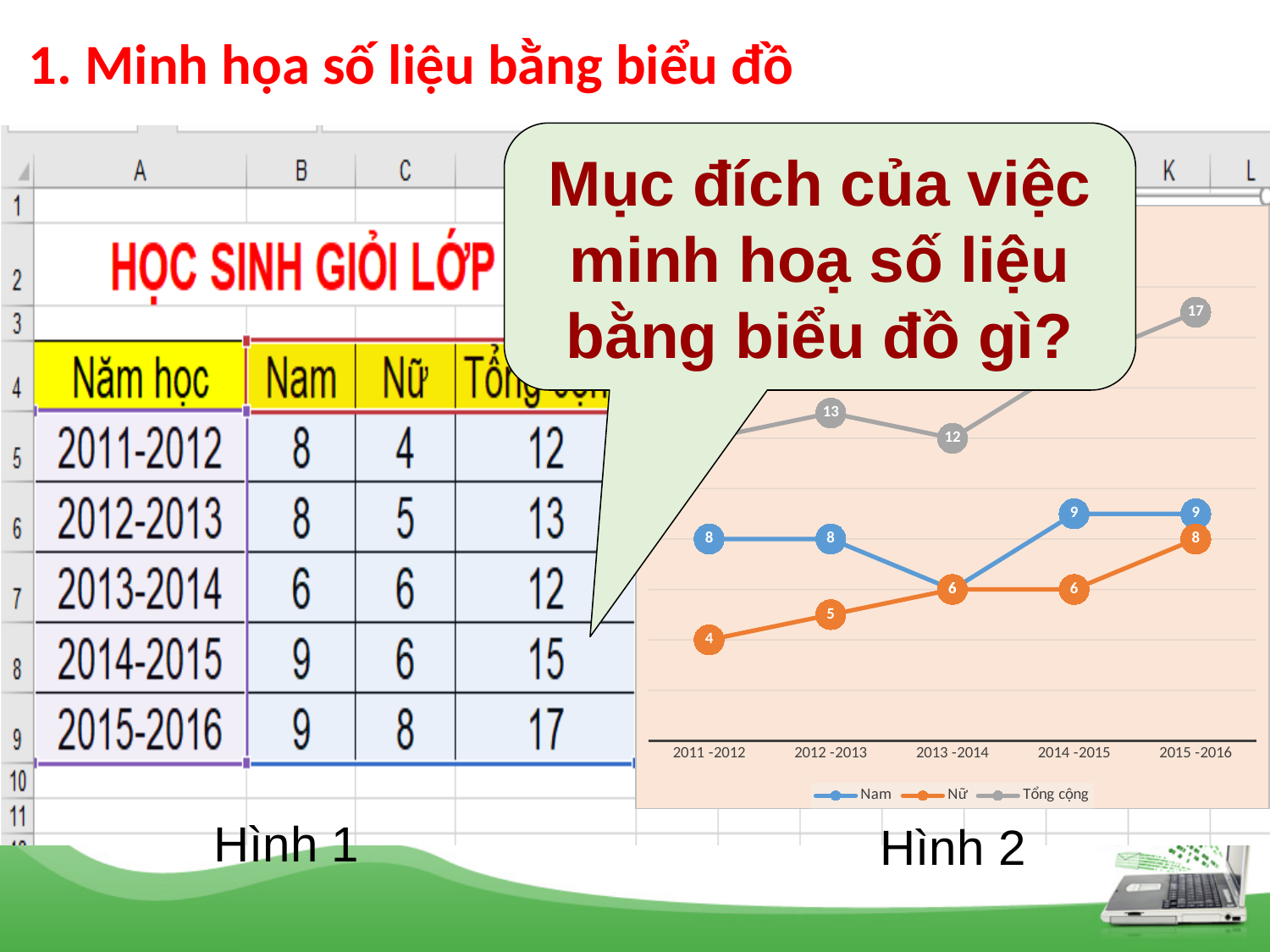
In the chart in Hình 2, which school year has the lowest value for Nữ? 2011-2012 In the chart in Hình 2, what is the value of Nam for 2013-2014? 6 What kind of chart is shown in Hình 2? line chart In the chart in Hình 2, what is the difference between Nam and Nữ for 2012-2013? 3 In the chart in Hình 2, does the Nữ series generally rise or fall from 2011-2012 to 2015-2016? rise In the chart in Hình 2, what is the value of Tổng cộng for 2015-2016? 17 In the chart in Hình 2, what is the value of Nữ for 2011-2012? 4 In the chart in Hình 2, what is the value of Nữ for 2015-2016? 8 In the chart in Hình 2, how many series does the legend list? 3 In the chart in Hình 2, which school year has the lowest value for Nam? 2013-2014 In the chart in Hình 2, how many school years are shown on the x axis? 5 In the chart in Hình 2, which is larger for 2014-2015, Nam or Nữ? Nam